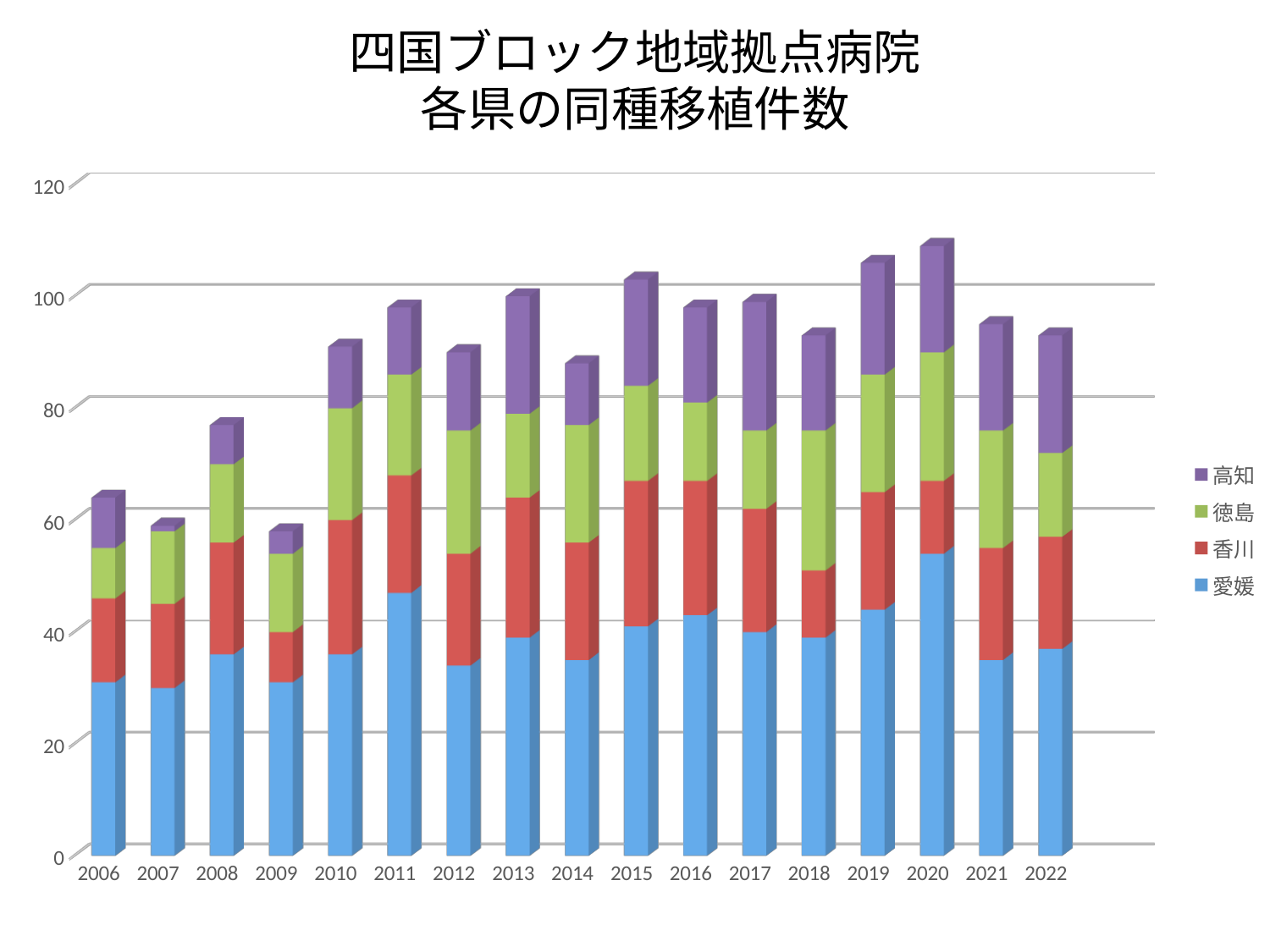
Which series is shown at the bottom of each stacked bar (blue)? 愛媛 Which year has the larger total, 2006 or 2008? 2008 Is the total for 2014 greater or less than 80? greater Is the total for 2006 greater or less than 60? greater Which year has the larger total, 2009 or 2010? 2010 Is the total for 2022 greater or less than 100? less Do the stacked totals rise or fall from 2009 to 2011? rise How many series does the legend list? 4 Which year has the tallest stacked bar (highest total)? 2020 How many years are shown along the x axis? 17 What kind of chart is shown on the slide? Stacked bar chart